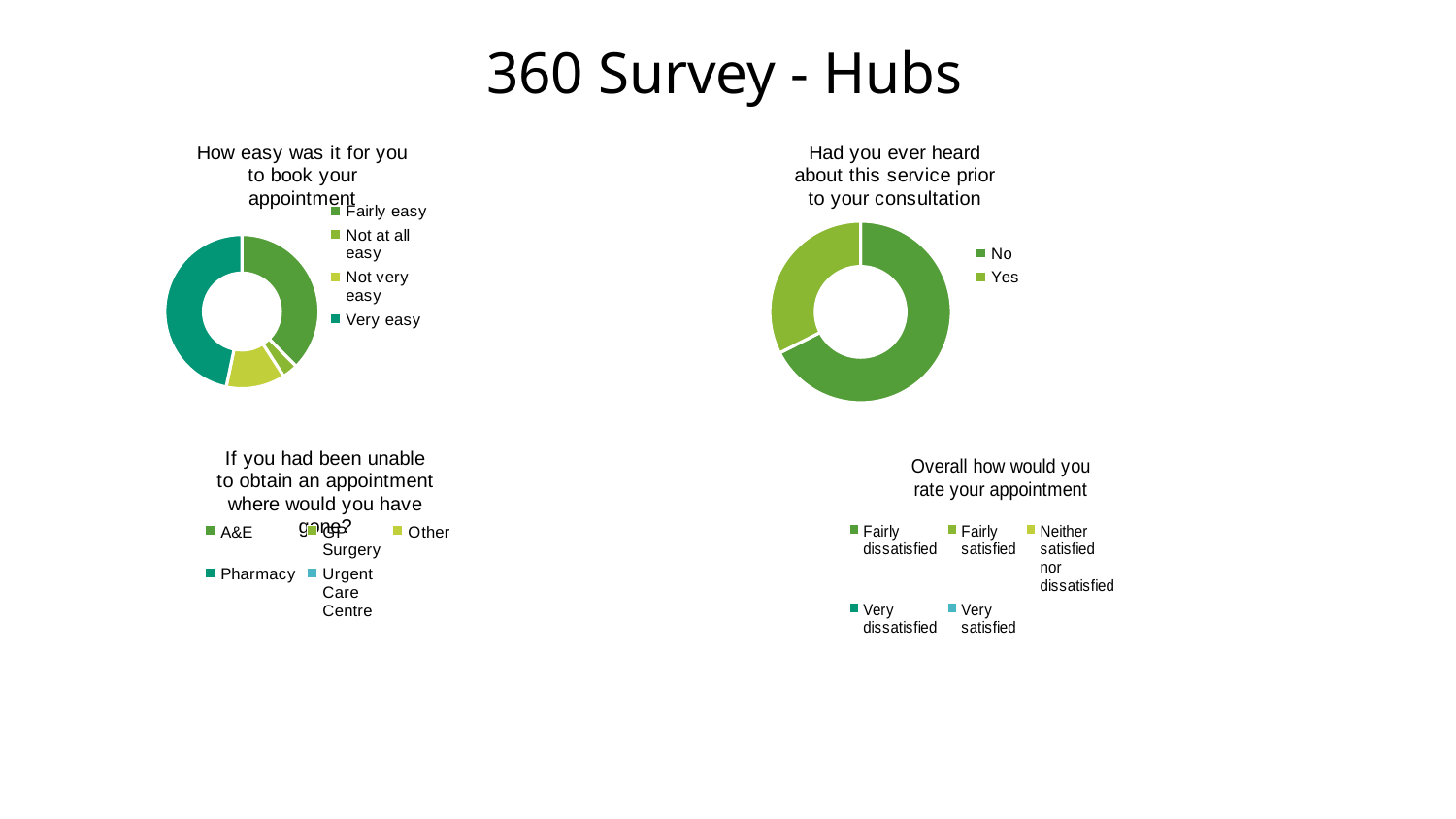
How many categories does the legend of the 'Had you ever heard about this service prior to your consultation' chart list? 2 In the 'How easy was it for you to book your appointment' chart, which response has the largest share? Very easy What kind of chart is the 'How easy was it for you to book your appointment' chart? Doughnut chart What is the title of the slide? 360 Survey - Hubs In the 'Had you ever heard about this service prior to your consultation' chart, which is smaller: Yes or No? Yes In the 'Had you ever heard about this service prior to your consultation' chart, which response has the larger share? No How many categories does the legend of the 'If you had been unable to obtain an appointment where would you have gone?' chart list? 5 In the 'How easy was it for you to book your appointment' chart, which is larger: Fairly easy or Not very easy? Fairly easy In the 'How easy was it for you to book your appointment' chart, which response has the smallest share? Not at all easy How many categories does the legend of the 'How easy was it for you to book your appointment' chart list? 4 Which legend entries appear in the 'Had you ever heard about this service prior to your consultation' chart? No, Yes